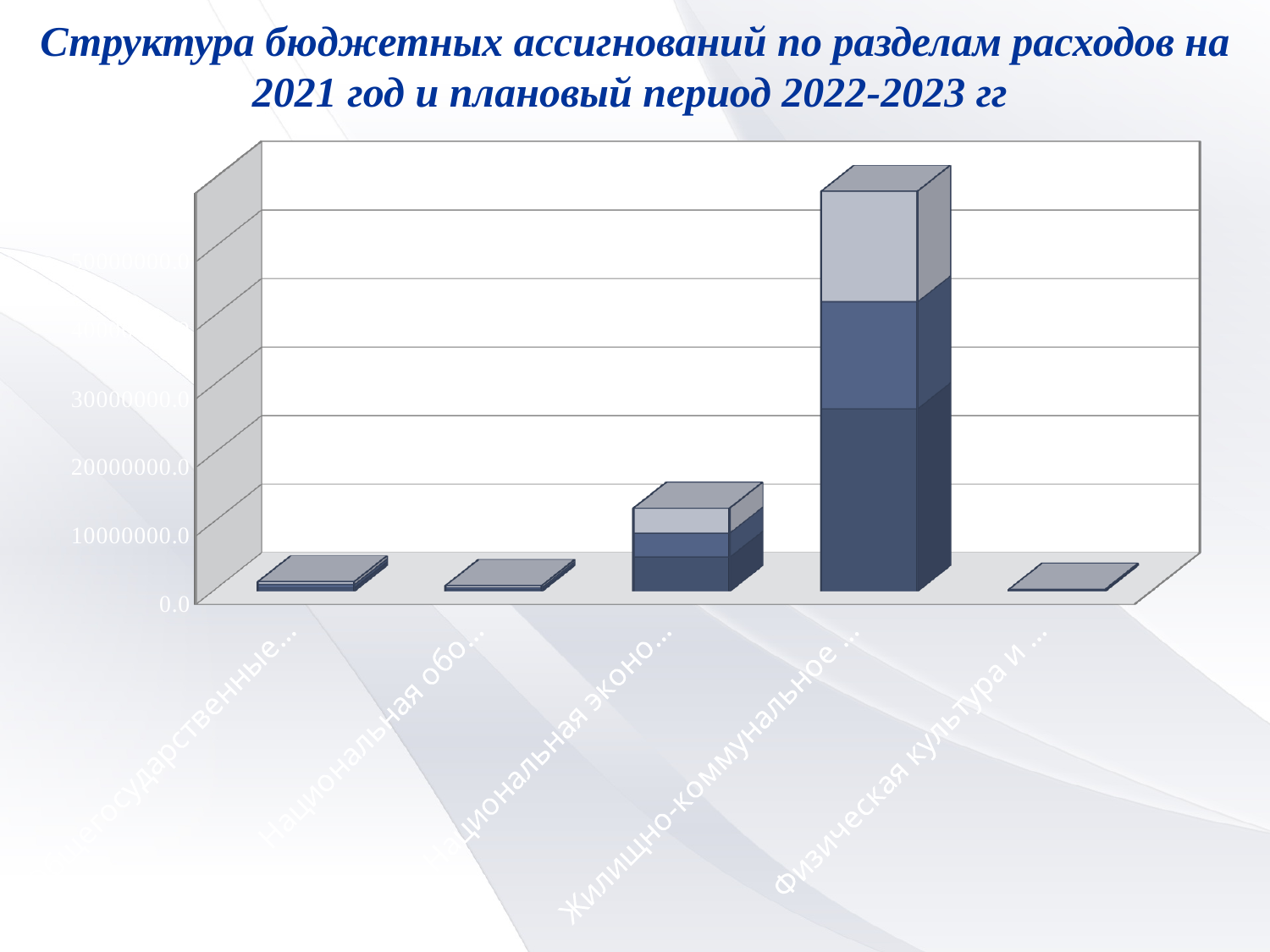
Is the total value for "Жилищно-коммунальное ..." greater or less than 30000000.0? greater What is the title of the slide containing the chart? Структура бюджетных ассигнований по разделам расходов на 2021 год и плановый период 2022-2023 гг Which bar is taller: "Национальная эконо..." or "Жилищно-коммунальное ..."? Жилищно-коммунальное ... How many categories are plotted along the x axis of the chart? 5 Which bar is taller: "Национальная обо..." or "Национальная эконо..."? Национальная эконо... Is the value for "Общегосударственные..." greater or less than 10000000.0? less What kind of chart is shown on the slide? bar chart Is the total value for "Национальная эконо..." greater or less than 20000000.0? less Which category has the tallest bar in the chart? Жилищно-коммунальное ... How many stacked segments make up the bar for "Жилищно-коммунальное ..."? 3